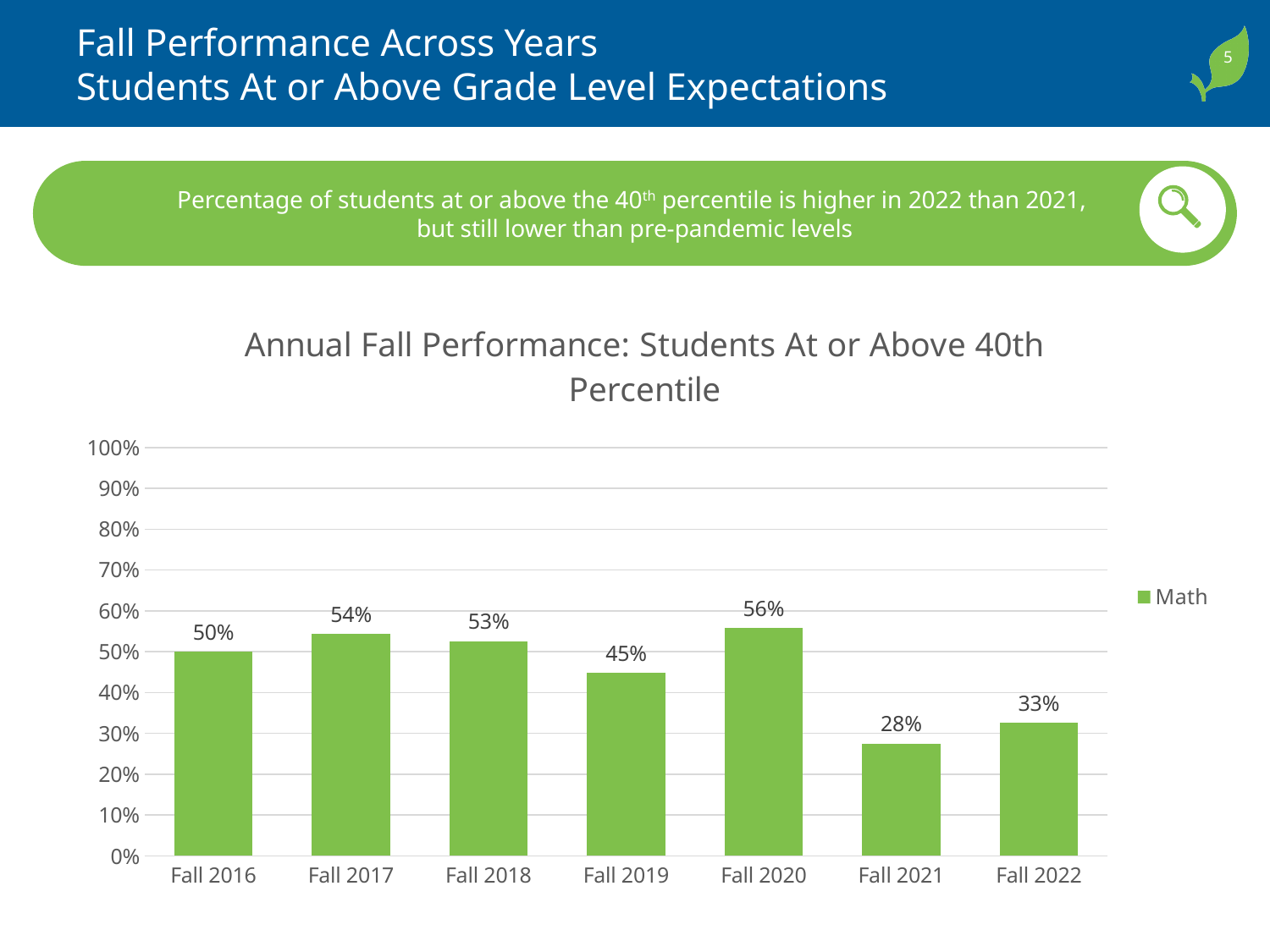
Which is larger, the Math value for Fall 2017 or Fall 2019? Fall 2017 How many years are shown on the x axis? 7 What is the Math value for Fall 2016? 50% Which year has the highest Math value? Fall 2020 What is the Math value for Fall 2022? 33% What is the difference between the Math values for Fall 2022 and Fall 2021? 5% Which year has the lowest Math value? Fall 2021 Is the Math value for Fall 2019 greater or less than 40%? greater What kind of chart is shown on the slide? Bar chart How many series does the legend list? 1 What is the difference between the Math values for Fall 2020 and Fall 2021? 28% What is the Math value for Fall 2021? 28%